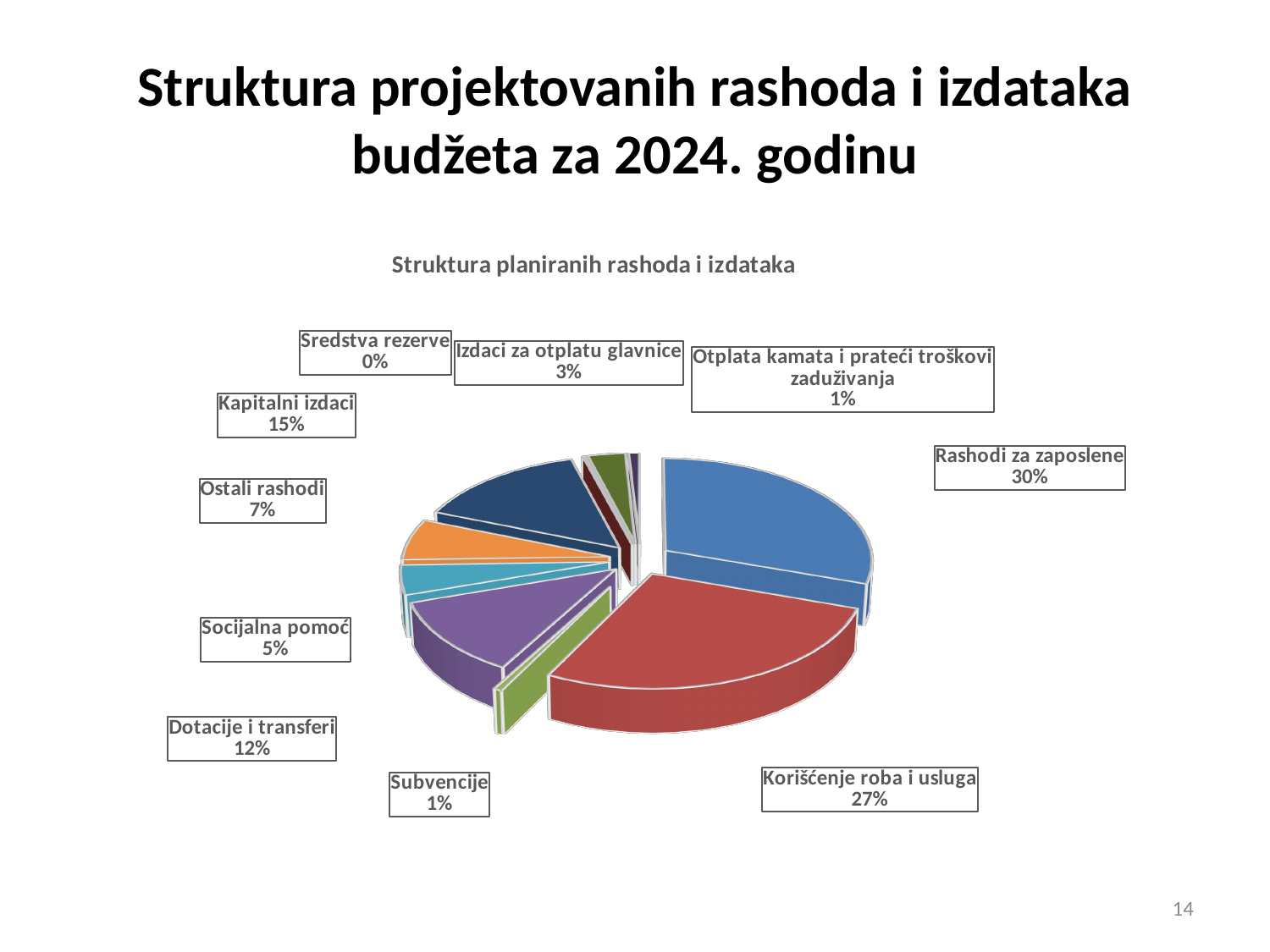
What is the difference in percentage points between Rashodi za zaposlene and Korišćenje roba i usluga? 3 percentage points What is the share for Dotacije i transferi? 12% What type of chart is shown on the slide? Pie chart What is the share for Izdaci za otplatu glavnice? 3% What is the share for Korišćenje roba i usluga? 27% Which is larger, the share for Ostali rashodi or the share for Socijalna pomoć? Ostali rashodi Which category has the largest share of the pie? Rashodi za zaposlene What is the title of the chart? Struktura planiranih rashoda i izdataka What is the share for Kapitalni izdaci? 15% How many categories are shown in the pie chart? 10 What is the share for Rashodi za zaposlene? 30% Which category has the smallest share of the pie? Sredstva rezerve